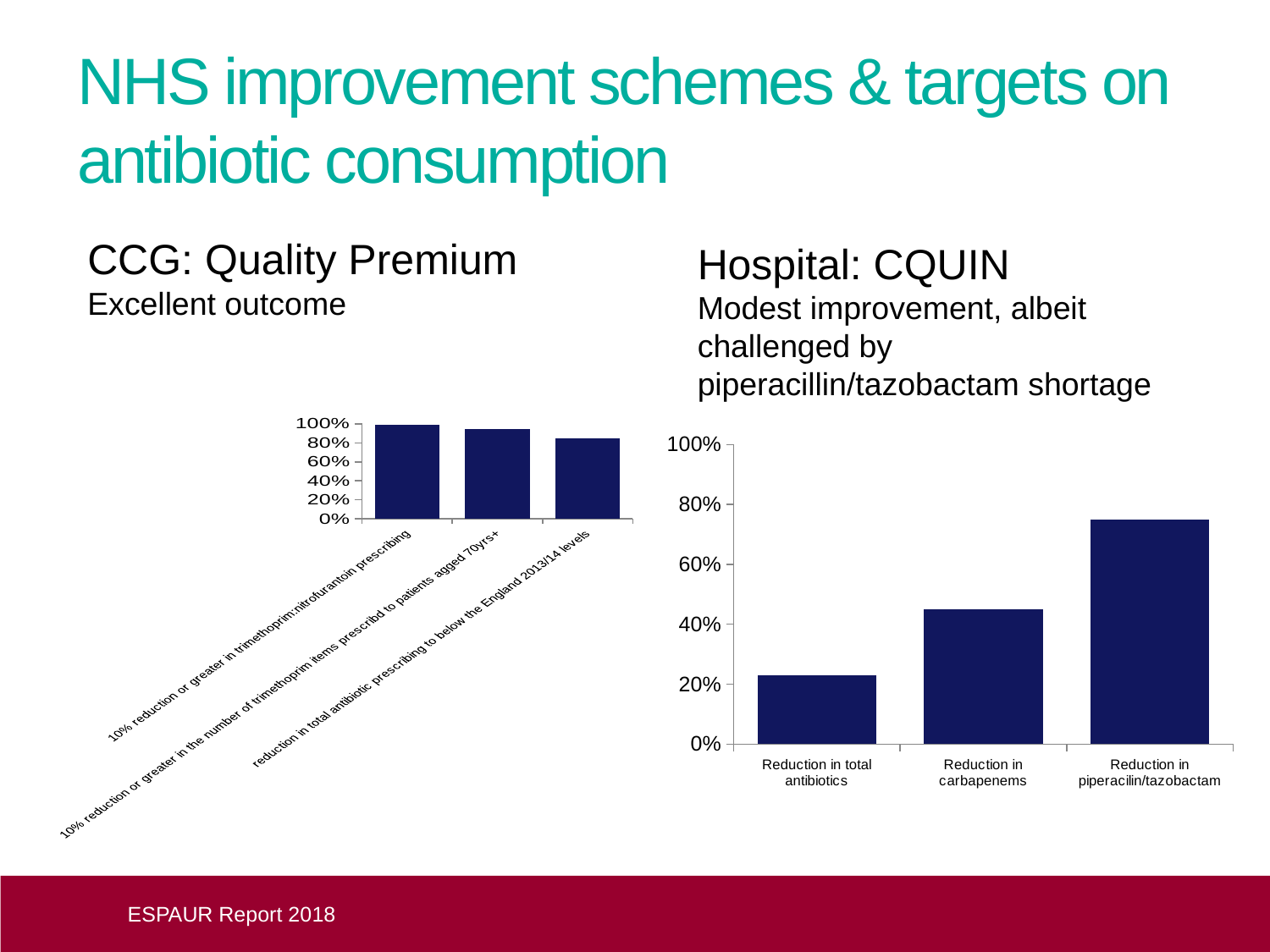
Do the values in the left-hand chart (CCG: Quality Premium) rise or fall from left to right? fall In the right-hand chart (Hospital: CQUIN), which category has the highest value? Reduction in piperacilin/tazobactam What kind of chart is the left-hand chart (CCG: Quality Premium)? bar chart In the right-hand chart (Hospital: CQUIN), is the value for Reduction in carbapenems greater or less than 60%? less How many categories are shown in the right-hand chart (Hospital: CQUIN)? 3 In the right-hand chart (Hospital: CQUIN), which category has the lowest value? Reduction in total antibiotics In the right-hand chart (Hospital: CQUIN), is the value for Reduction in piperacilin/tazobactam greater or less than 60%? greater How many bars are shown in the left-hand chart (CCG: Quality Premium)? 3 In the right-hand chart (Hospital: CQUIN), which is larger: Reduction in carbapenems or Reduction in total antibiotics? Reduction in carbapenems In the right-hand chart (Hospital: CQUIN), is the value for Reduction in total antibiotics greater or less than 40%? less Do the values in the right-hand chart (Hospital: CQUIN) rise or fall from left to right? rise